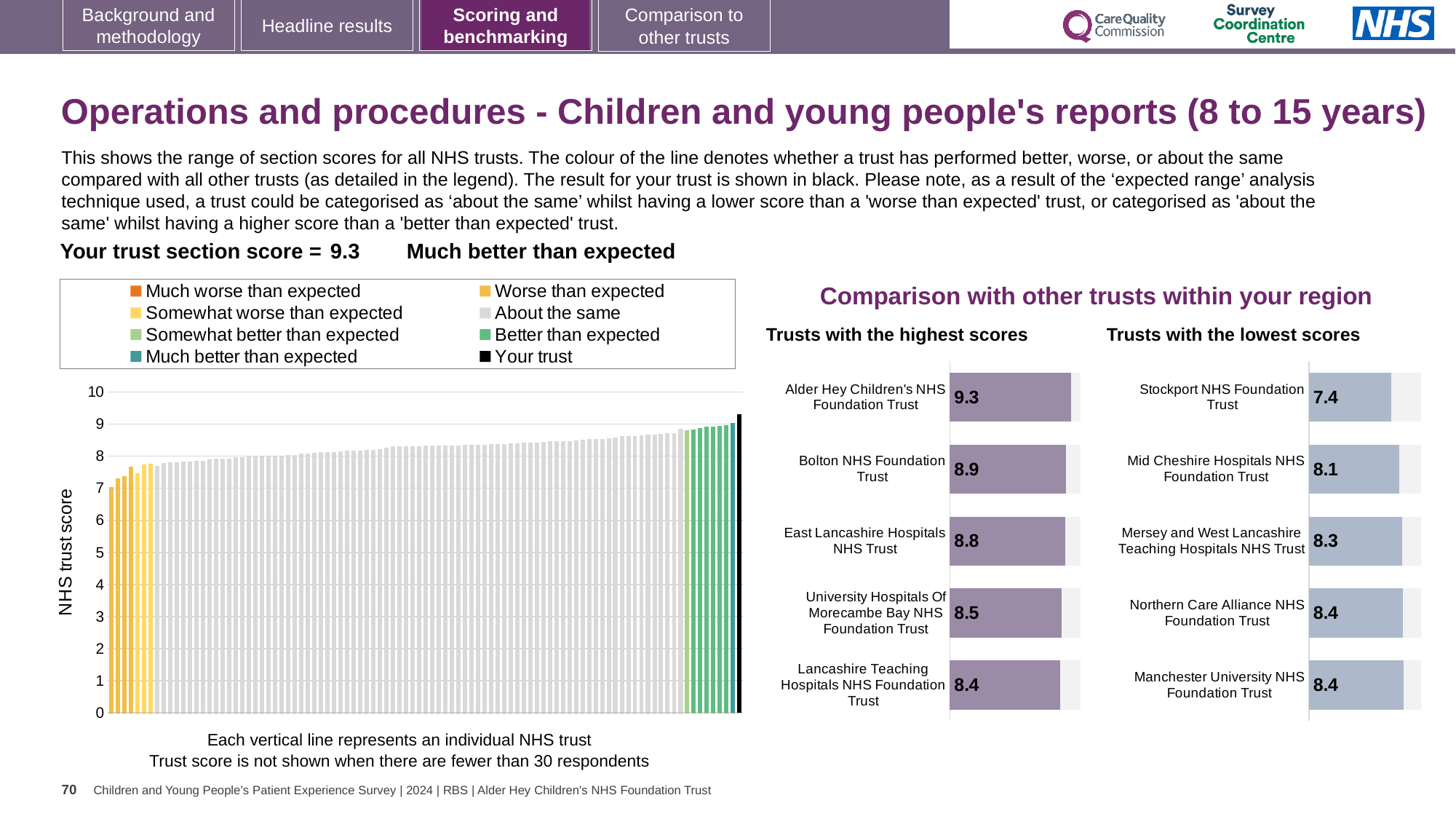
In the 'Trusts with the highest scores' chart, what is the score for Bolton NHS Foundation Trust? 8.9 In the 'Trusts with the highest scores' chart, which trust has the highest score? Alder Hey Children's NHS Foundation Trust In the 'Trusts with the highest scores' chart, what is the difference between the scores of Alder Hey Children's NHS Foundation Trust and Lancashire Teaching Hospitals NHS Foundation Trust? 0.9 In the 'Trusts with the lowest scores' chart, which trust has the lowest score? Stockport NHS Foundation Trust In the large chart on the left, do the trust scores rise or fall from left to right? Rise In the 'Trusts with the lowest scores' chart, what is the difference between the scores of Northern Care Alliance NHS Foundation Trust and Stockport NHS Foundation Trust? 1.0 In the 'Trusts with the lowest scores' chart, which has the higher score: Mid Cheshire Hospitals NHS Foundation Trust or Mersey and West Lancashire Teaching Hospitals NHS Trust? Mersey and West Lancashire Teaching Hospitals NHS Trust How many entries does the legend above the large chart on the left list? 8 What kind of chart is the large chart on the left showing NHS trust scores? Bar chart In the 'Trusts with the lowest scores' chart, what is the score for Stockport NHS Foundation Trust? 7.4 How many trusts are shown in the 'Trusts with the highest scores' chart? 5 In the large chart on the left, what is the section score for your trust (the black bar)? 9.3